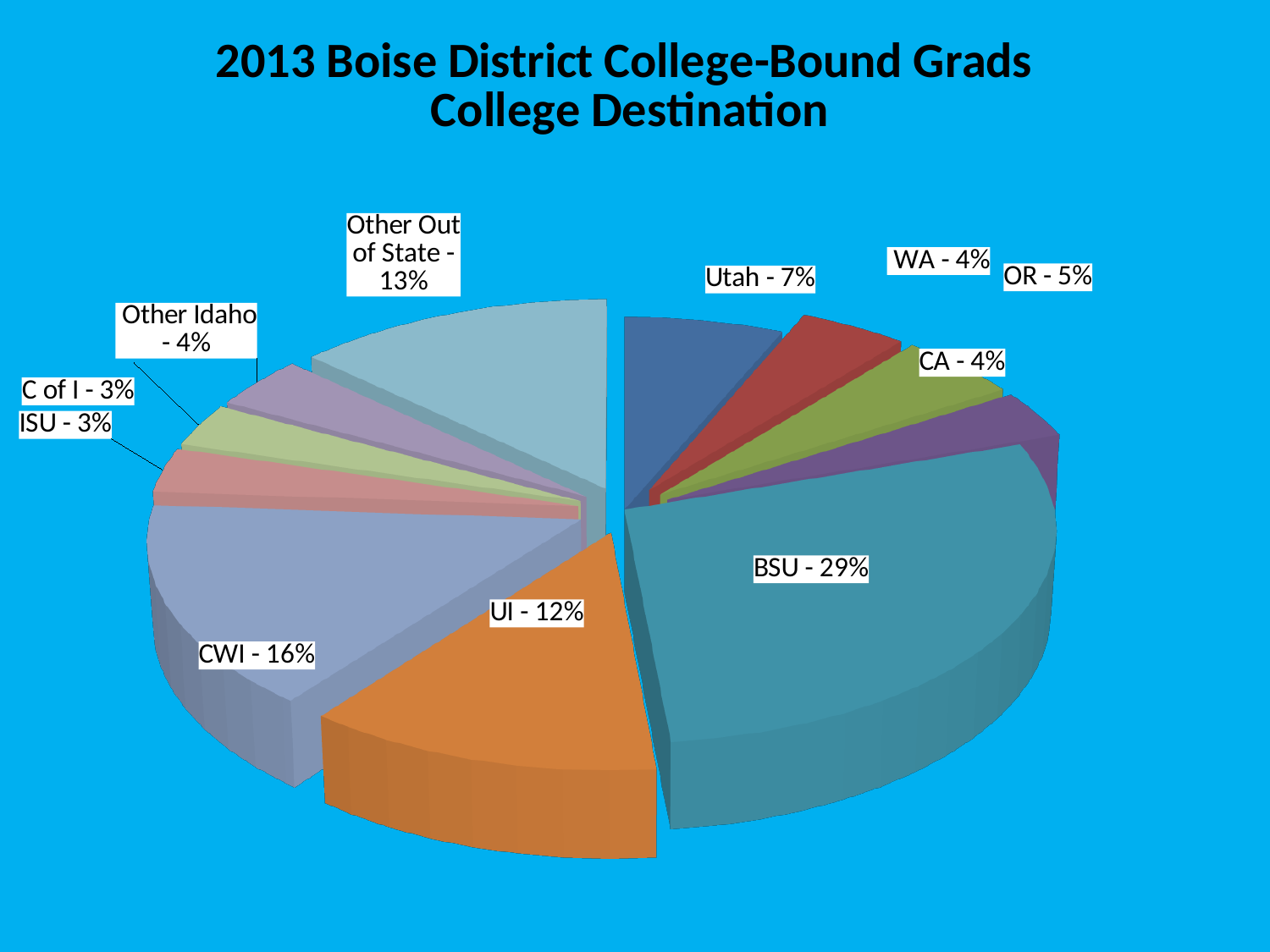
Which destinations share the smallest percentage on the chart? ISU and C of I (3% each) What percentage is shown for OR? 5% What percentage of grads went to CWI? 16% What is the title of the chart? 2013 Boise District College-Bound Grads College Destination What is the difference in percentage points between BSU and CWI? 13 What kind of chart is shown on the slide? Pie chart Which destination has the largest share of the pie? BSU How many slices does the pie chart have? 11 What share of college-bound grads went to BSU? 29% Which has a larger share, UI or Other Out of State? Other Out of State What percentage is shown for Other Out of State? 13% What percentage of grads went to Utah? 7%